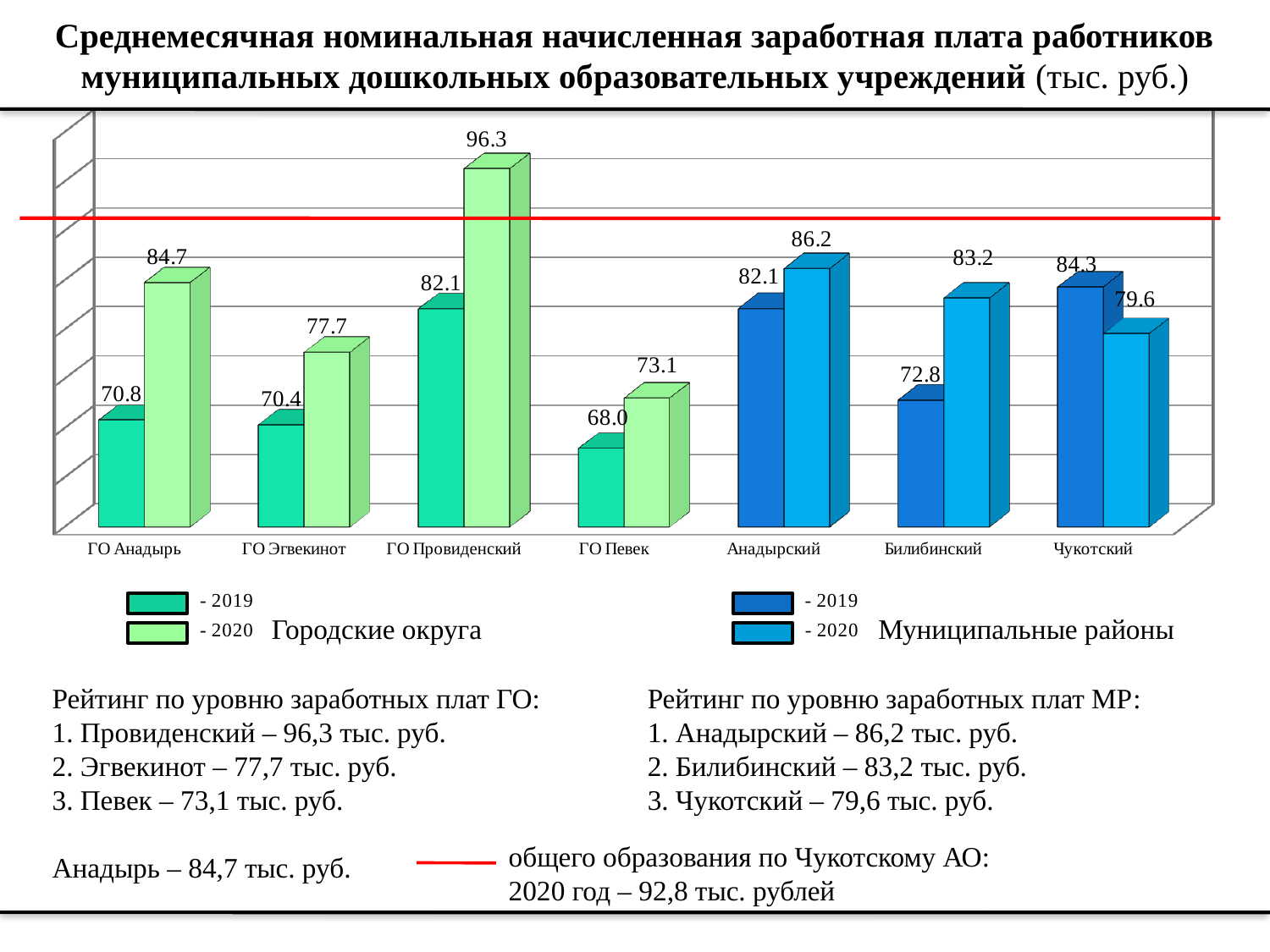
What is the 2020 value for Билибинский? 83.2 What is the difference between the 2020 values for Анадырский and Билибинский? 3.0 How many categories are shown on the x axis? 7 What is the difference between the 2020 and 2019 values for ГО Анадырь? 13.9 How many series does the legend list for each group? 2 What kind of chart is shown on the slide? bar chart What is the 2019 value for ГО Певек? 68.0 Which is larger for Чукотский: the 2019 value or the 2020 value? 2019 Which category has the lowest 2019 value? ГО Певек What value does the red horizontal line represent, according to the slide? 92,8 тыс. рублей Which category has the highest 2020 value? ГО Провиденский What is the 2020 value for ГО Провиденский? 96.3